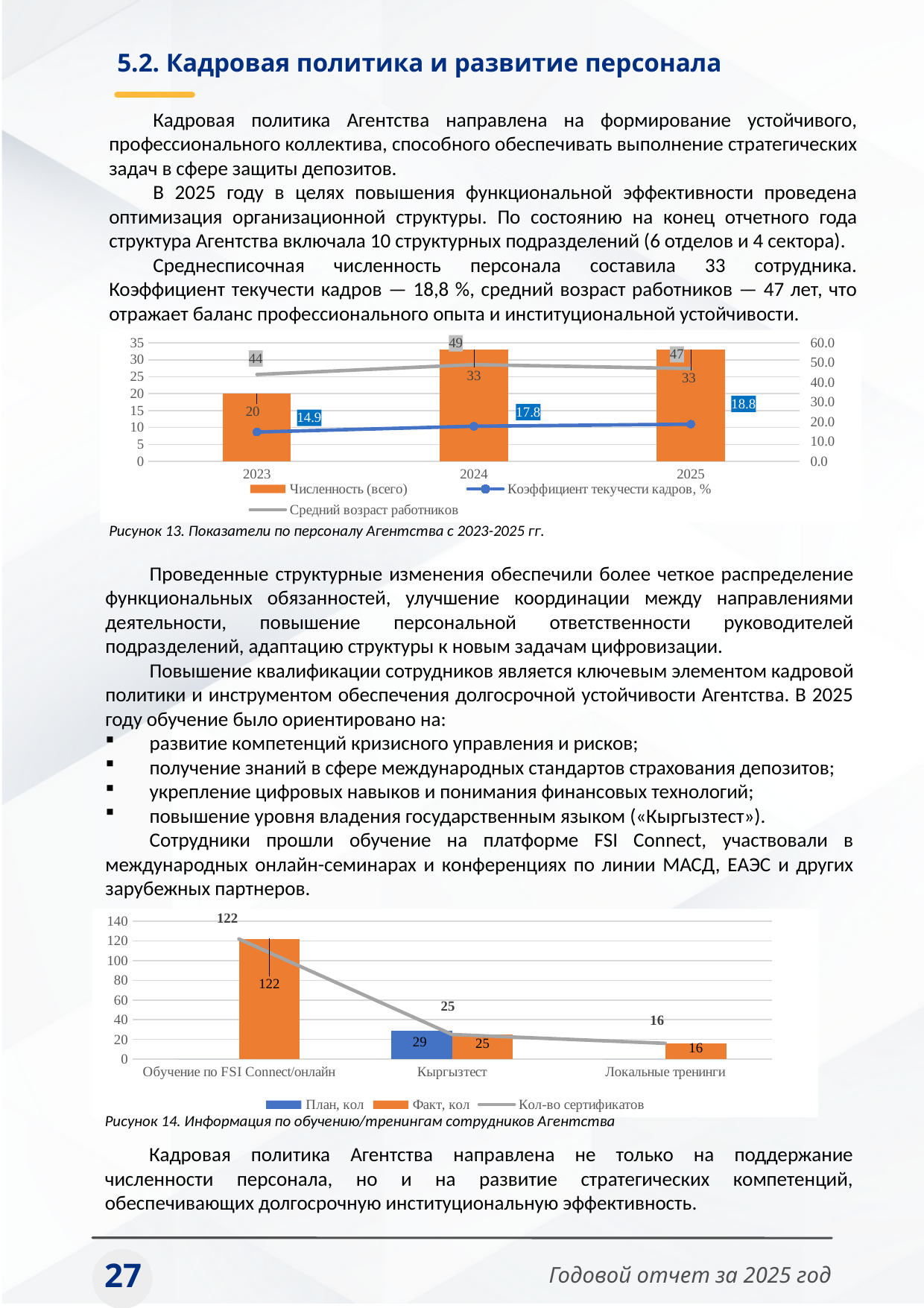
In the top chart (Рисунок 13), what is the Средний возраст работников for 2024? 49 In the top chart (Рисунок 13), in which year is the Средний возраст работников highest? 2024 In the bottom chart (Рисунок 14), what is the Факт, кол value for Обучение по FSI Connect/онлайн? 122 In the bottom chart (Рисунок 14), what is the difference between the Факт, кол values for Кыргызтест and Локальные тренинги? 9 In the bottom chart (Рисунок 14), how many categories are shown on the x axis? 3 In the top chart (Рисунок 13), what is the Коэффициент текучести кадров, % for 2025? 18.8 In the bottom chart (Рисунок 14), which category has the lowest Факт, кол value? Локальные тренинги In the top chart (Рисунок 13), what is the value of Численность (всего) for 2023? 20 In the top chart (Рисунок 13), by how much did Численность (всего) increase from 2023 to 2024? 13 In the top chart (Рисунок 13), does the Коэффициент текучести кадров, % rise or fall from 2023 to 2025? rise In the bottom chart (Рисунок 14), what is the План, кол value for Кыргызтест? 29 In the top chart (Рисунок 13), how many series does the legend list? 3